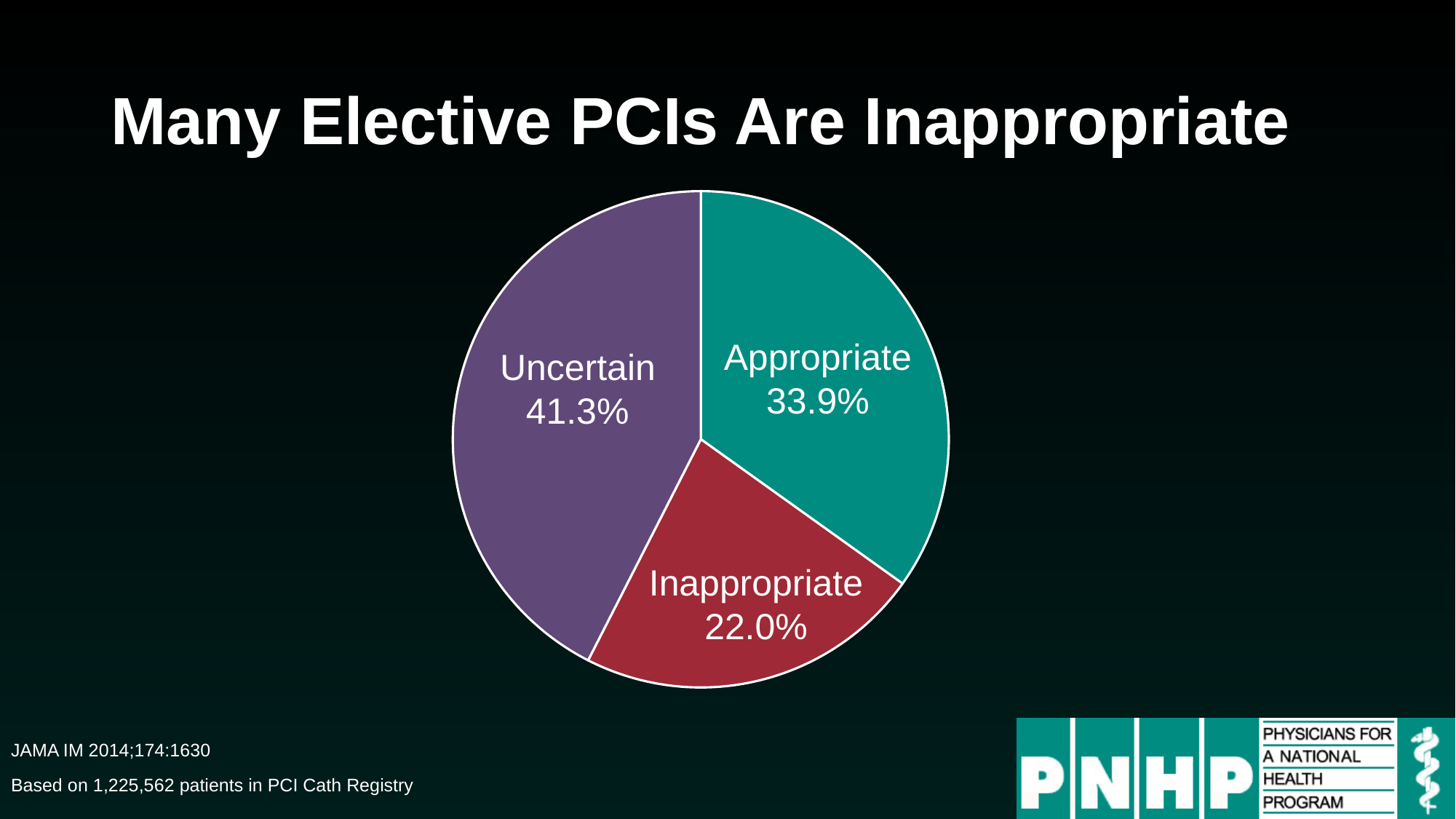
What is the difference in percentage points between the Appropriate and Inappropriate slices? 11.9 What percentage of elective PCIs are labelled Inappropriate? 22.0% What is the title of the slide containing the pie chart? Many Elective PCIs Are Inappropriate How many slices does the pie chart have? 3 Which is larger, the Appropriate slice or the Inappropriate slice? Appropriate What kind of chart is shown on the slide? pie chart What percentage of elective PCIs are labelled Appropriate? 33.9% What is the difference in percentage points between the Uncertain and Appropriate slices? 7.4 Which category has the smallest share of the pie? Inappropriate What colour is the Inappropriate slice of the pie chart? red Which category has the largest share of the pie? Uncertain What percentage of elective PCIs are labelled Uncertain? 41.3%